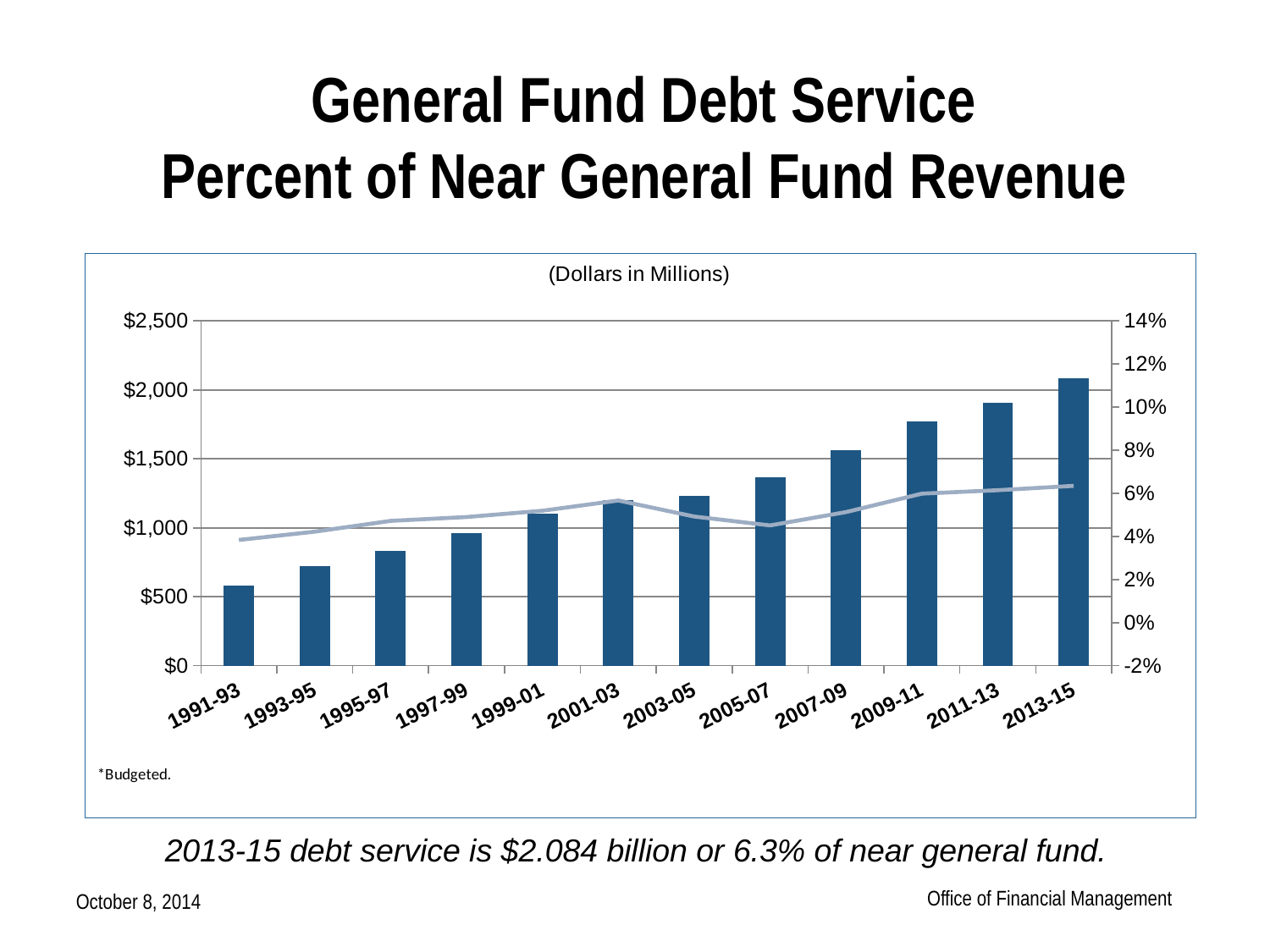
What unit does the chart subtitle say the bar values are in? Dollars in Millions How many biennium categories are shown on the x axis? 12 Do the bar values generally rise or fall from 1991-93 to 2013-15? Rise Which bar is taller, 2011-13 or 2009-11? 2011-13 Is the bar value for 2009-11 greater or less than $1,500? greater Is the line value for 2005-07 greater or less than 6%? less Is the bar value for 2005-07 greater or less than $1,500? less Which biennium has the shortest bar? 1991-93 Which biennium has the tallest bar? 2013-15 What kind of chart is shown on the slide? A bar chart with a line overlay